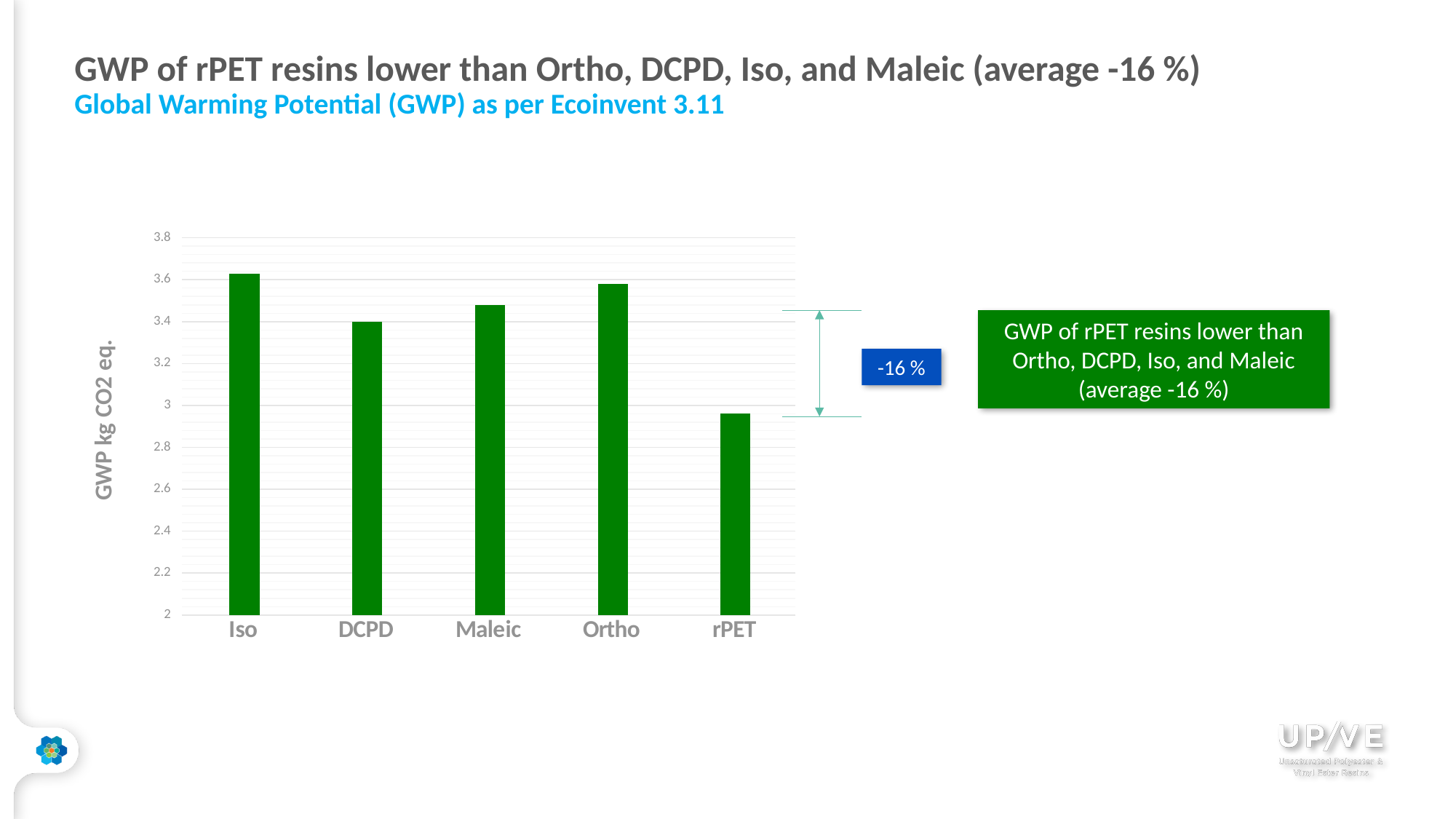
What kind of chart is shown on the slide? bar chart Which has a higher GWP, Iso or DCPD? Iso Which has a higher GWP, Ortho or Maleic? Ortho Which resin has the lowest GWP on the chart? rPET How many resin categories are plotted on the chart? 5 Is the GWP value for Ortho greater or less than 3.4? greater Is the GWP value for Iso greater or less than 3.4? greater Is the GWP value for Maleic greater or less than 3.4? greater Which resin has the highest GWP on the chart? Iso What is the label on the vertical axis of the chart? GWP kg CO2 eq. What percentage difference is annotated next to the chart between rPET and the other resins? -16 %